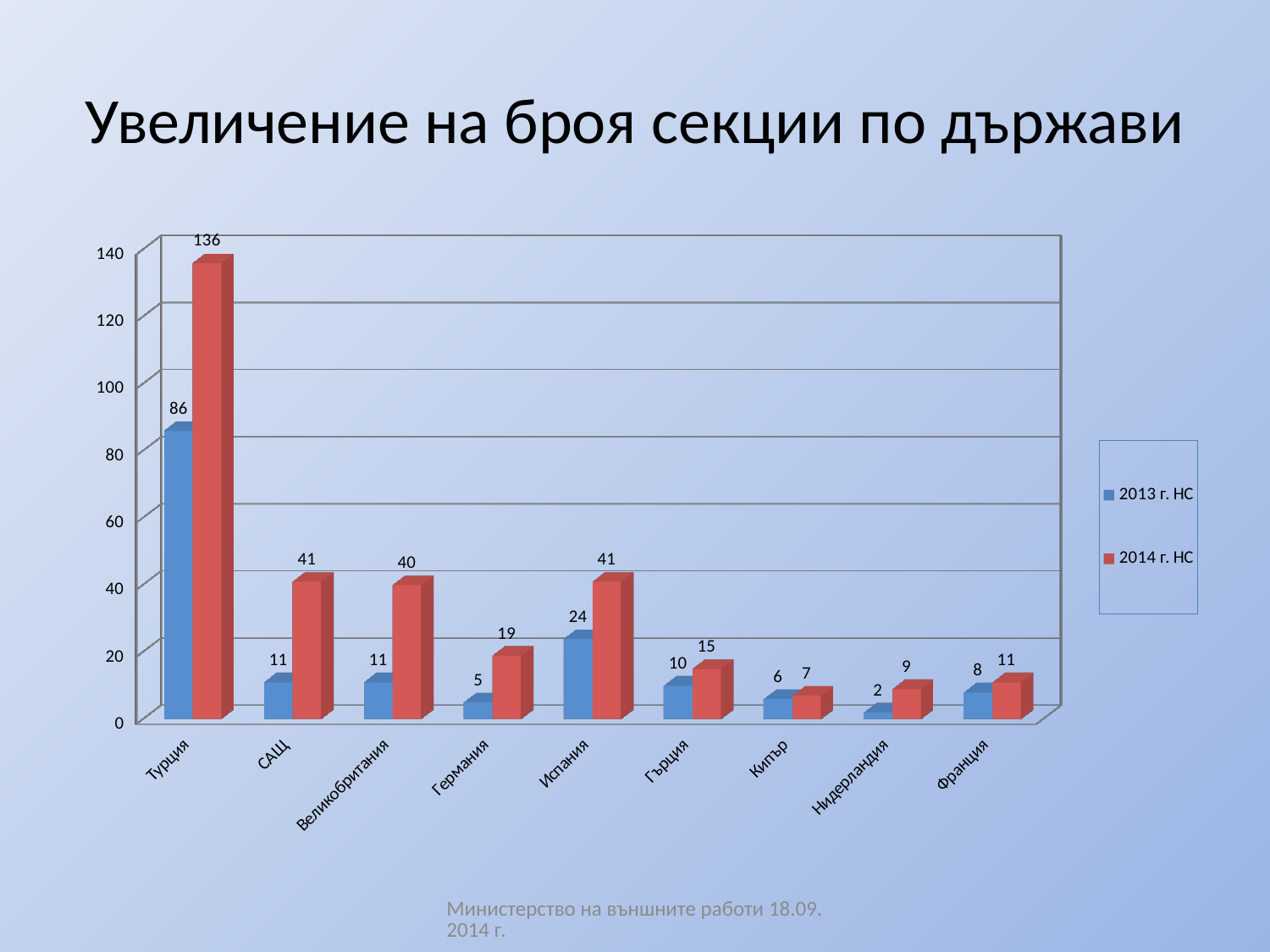
What is the value for Нидерландия in the 2013 г. НС series? 2 What is the difference between the 2014 г. НС and 2013 г. НС values for Турция? 50 Is the 2013 г. НС value for Турция greater or less than 80? greater Which is larger: the 2014 г. НС value for САЩ or the 2014 г. НС value for Германия? САЩ Which country has the lowest value in the 2013 г. НС series? Нидерландия Which country has the highest value in the 2014 г. НС series? Турция What kind of chart is shown on the slide? bar chart What is the difference between the 2014 г. НС and 2013 г. НС values for Великобритания? 29 How many countries are shown on the x axis? 9 How many series does the legend list? 2 What is the value for Турция in the 2014 г. НС series? 136 What is the value for Испания in the 2013 г. НС series? 24